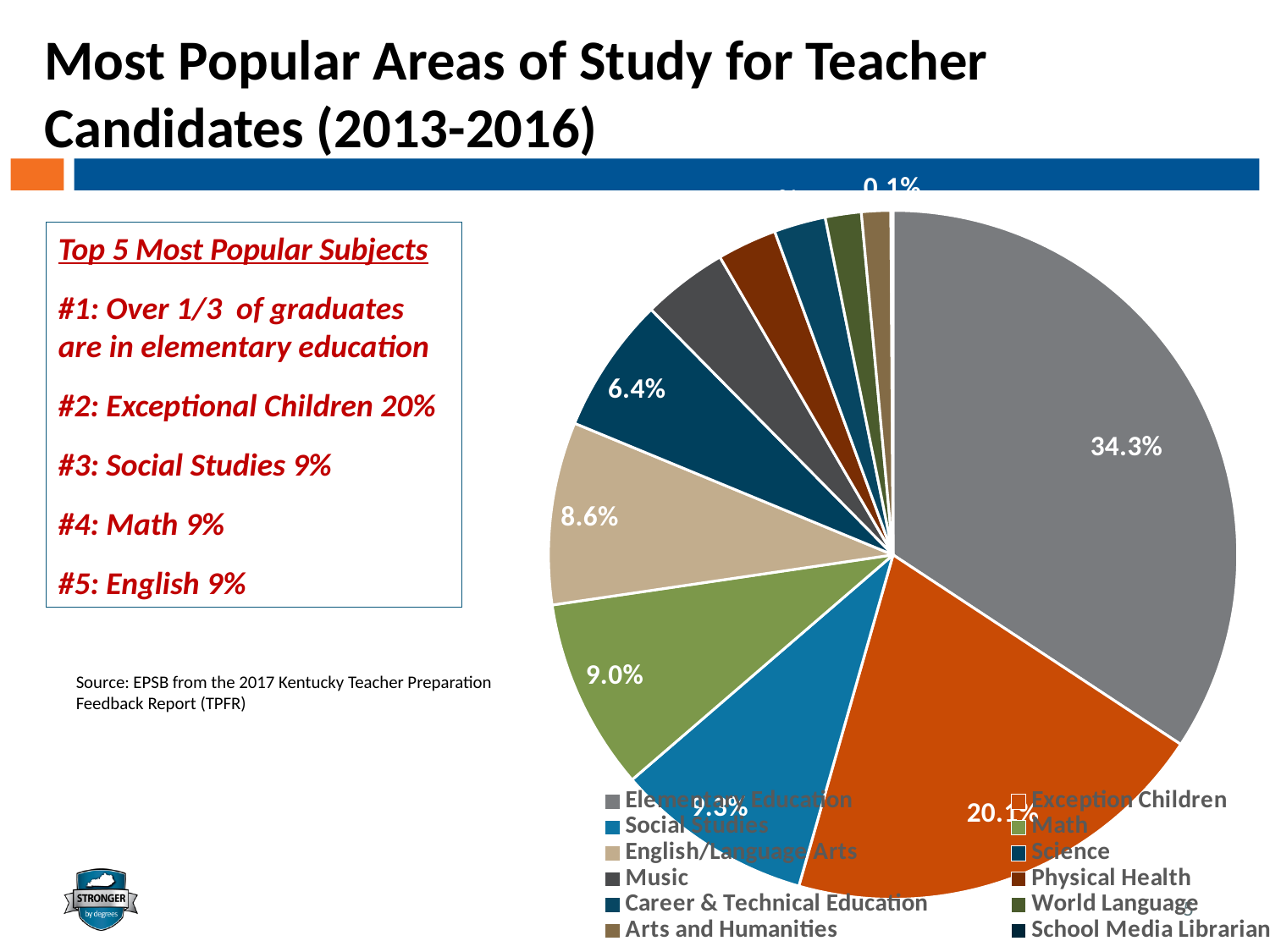
Which slice is larger, Social Studies or Math? Social Studies What share of the pie does Elementary Education have? 34.3% What percentage is shown for English/Language Arts? 8.6% What percentage is shown for Social Studies? 9.3% What percentage is shown for Exception Children? 20.1% What percentage is shown for Math? 9.0% How many percentage points larger is the Elementary Education slice than the Exception Children slice? 14.2 percentage points What is the title of the slide containing the chart? Most Popular Areas of Study for Teacher Candidates (2013-2016) Which area of study has the largest slice of the pie? Elementary Education What kind of chart is shown on the slide? Pie chart What percentage is shown for Science? 6.4% How many categories does the legend list? 12